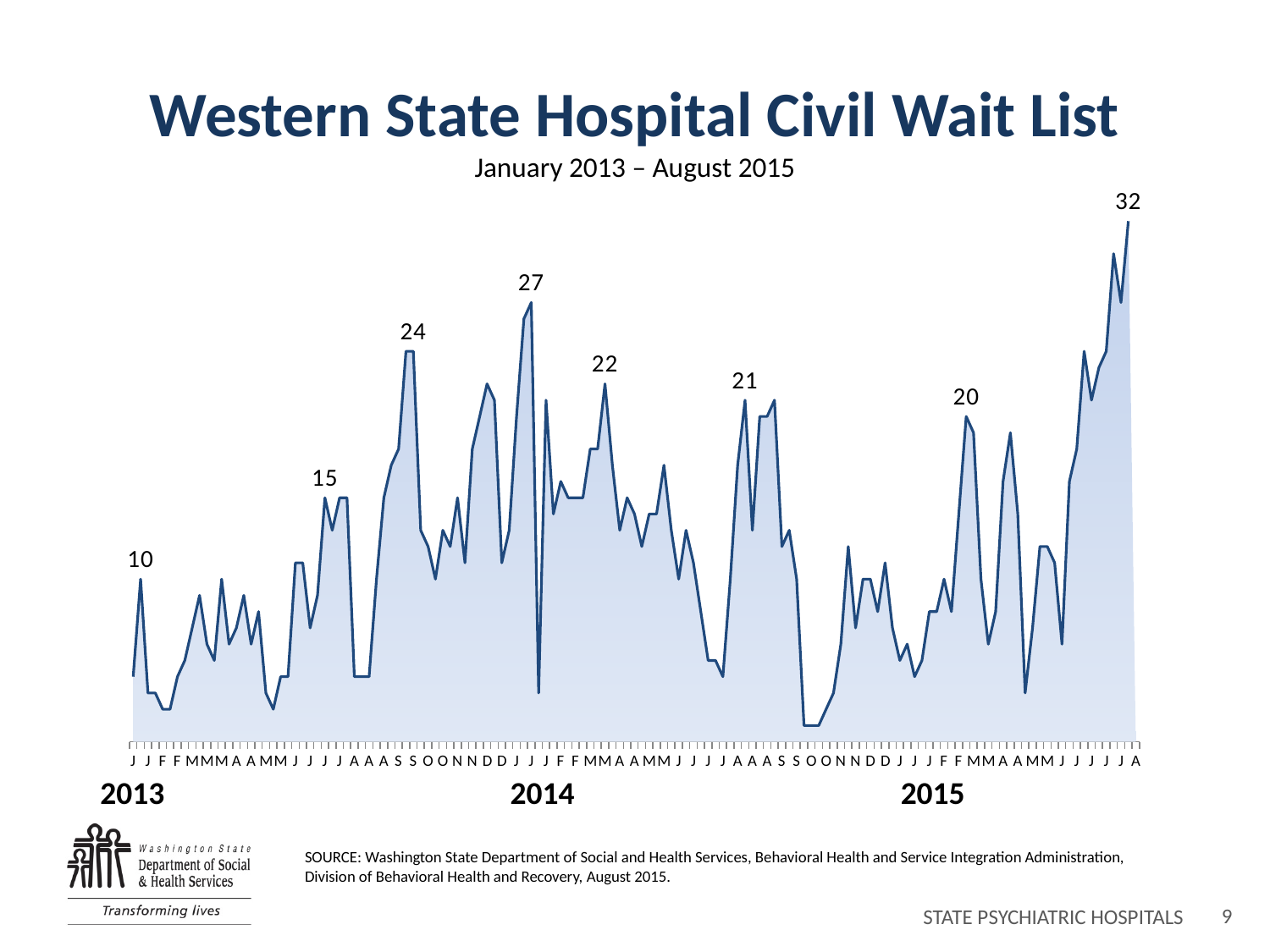
Does the wait list rise or fall over the final months of 2015 shown on the chart? Rise What is the lowest value among the labeled peaks on the chart? 10 What kind of chart is shown on the slide? Line chart (area chart) What value is labeled at the peak in early 2015? 20 What is the highest value labeled on the chart? 32 Which labeled peak is larger: the 24 in late 2013 or the 21 in mid-2014? 24 in late 2013 What value is labeled at the final peak in August 2015? 32 What is the title of the chart? Western State Hospital Civil Wait List What is the difference between the labeled peak of 32 in August 2015 and the labeled peak of 27 around the start of 2014? 5 How many years are labeled along the x axis? 3 What value is labeled at the peak around the start of 2014 (the highest point in the middle of the chart)? 27 What time period does the chart cover, according to its subtitle? January 2013 – August 2015